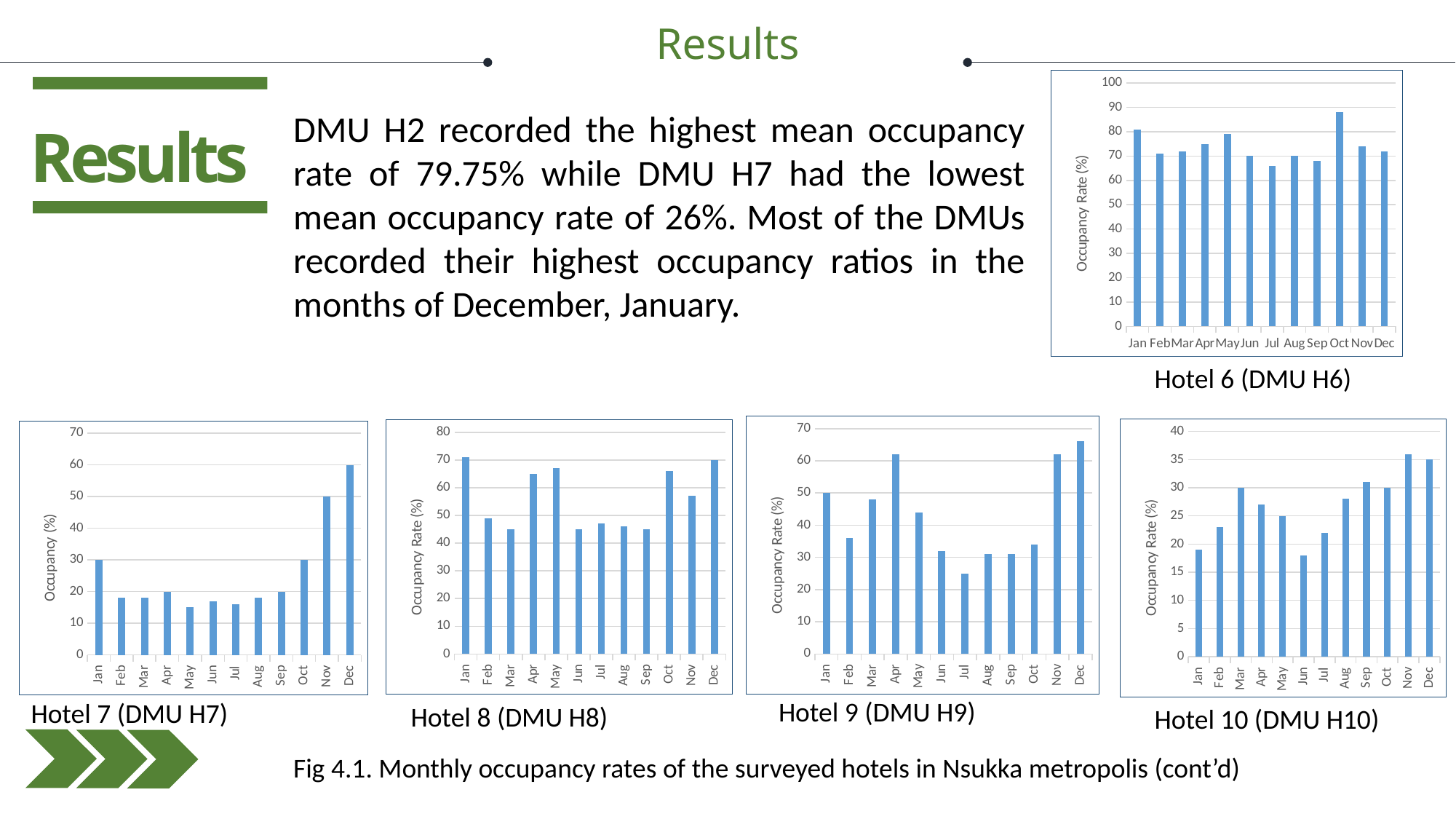
In the Hotel 7 (DMU H7) chart, which month has the lowest occupancy? May In the Hotel 8 (DMU H8) chart, which is larger, the value for Apr or the value for Feb? Apr In the Hotel 9 (DMU H9) chart, which month has the lowest occupancy rate? Jul In the Hotel 9 (DMU H9) chart, which month has the highest occupancy rate? Dec In the Hotel 7 (DMU H7) chart, which month has the highest occupancy? Dec In the Hotel 6 (DMU H6) chart, which month has the highest occupancy rate? Oct In the Hotel 7 (DMU H7) chart, do the values rise or fall from Sep to Dec? rise In the Hotel 6 (DMU H6) chart, is the value for Oct greater or less than 80? greater How many months are plotted in the Hotel 10 (DMU H10) chart? 12 In the Hotel 8 (DMU H8) chart, is the value for Nov greater or less than 50? greater In the Hotel 6 (DMU H6) chart, which month has the lowest occupancy rate? Jul In the Hotel 10 (DMU H10) chart, is the value for Jun greater or less than 20? less